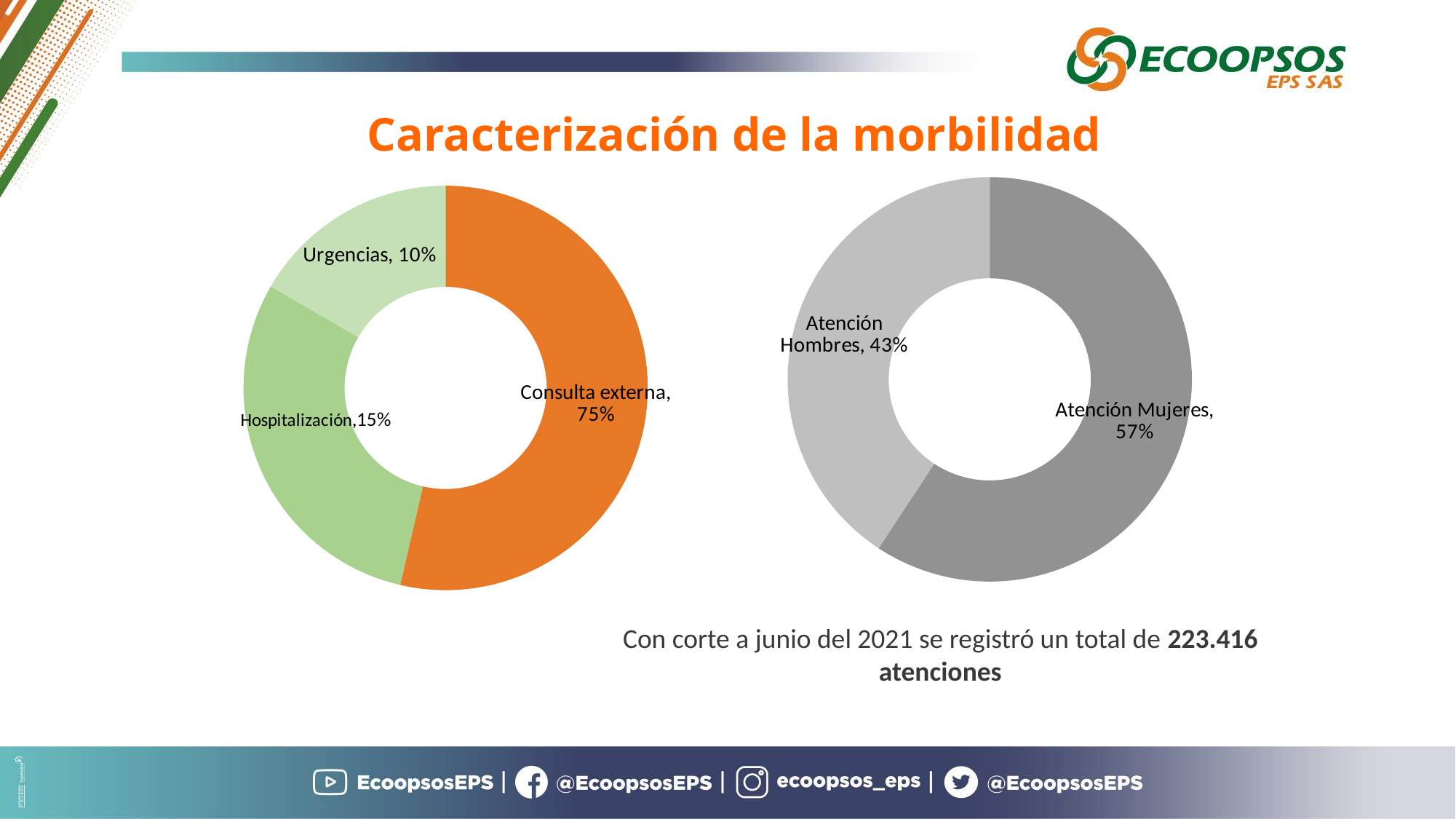
In the right chart, what is the value for Atención Hombres? 43% In the right chart, what is the value for Atención Mujeres? 57% In the left chart, what is the difference between Consulta externa and Hospitalización? 60% In the left chart, what is the value for Consulta externa? 75% In the right chart, which category is larger, Atención Mujeres or Atención Hombres? Atención Mujeres In the left chart, what is the value for Hospitalización? 15% How many categories does the left chart show? 3 What kind of chart is the right chart? Doughnut (pie) chart In the left chart, which category has the smallest share? Urgencias In the right chart, what is the difference between Atención Mujeres and Atención Hombres? 14% In the left chart, which category has the largest share? Consulta externa In the left chart, what is the value for Urgencias? 10%